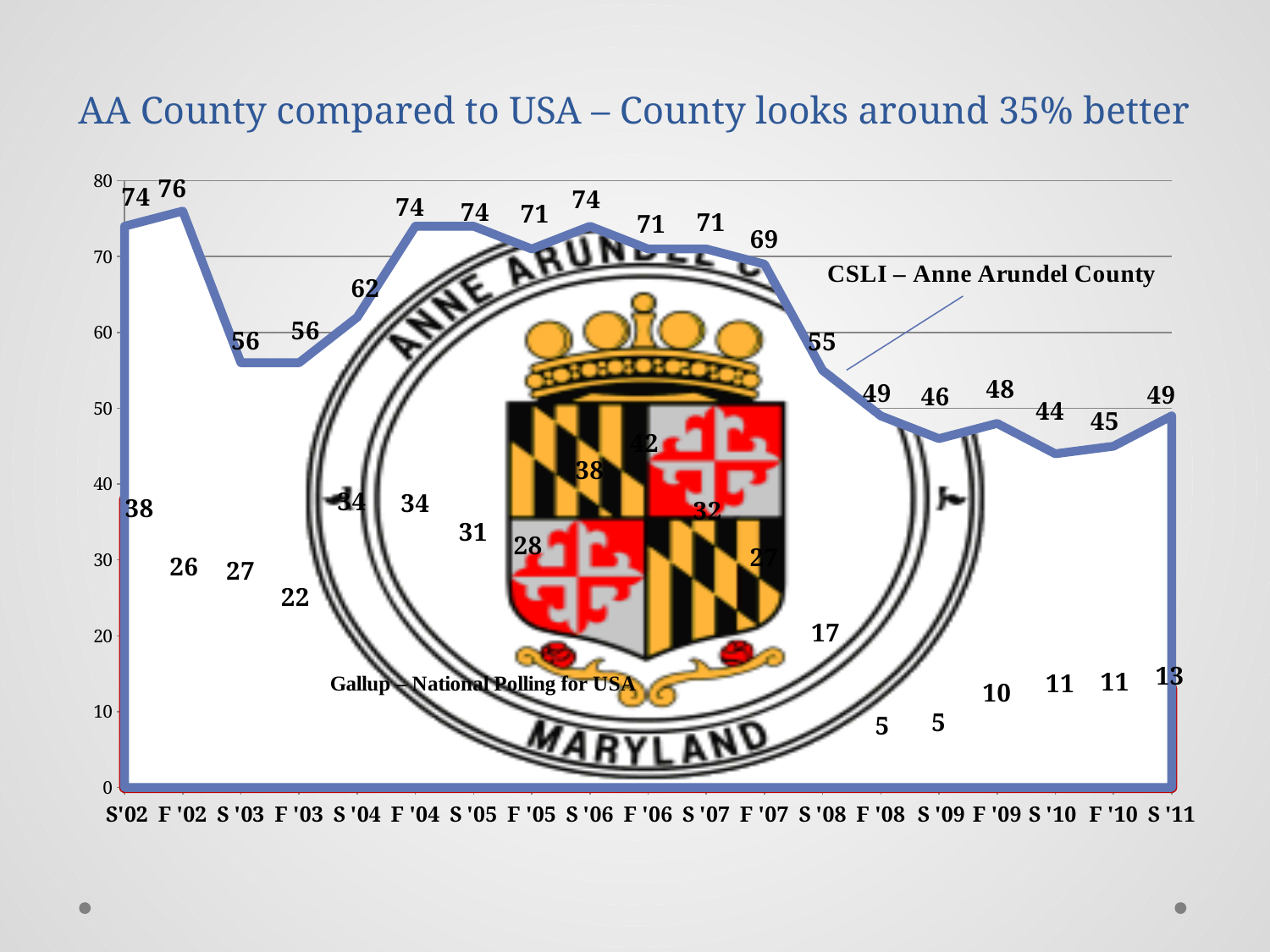
Which is larger for CSLI – Anne Arundel County: the value for S '04 or the value for F '04? F '04 What is the difference between the CSLI – Anne Arundel County value and the Gallup – National Polling for USA value for S '11? 36 What is the Gallup – National Polling for USA value for S '08? 17 In which period is the CSLI – Anne Arundel County value highest? F '02 Does the CSLI – Anne Arundel County value rise or fall from F '07 to S '10? Fall How many periods are shown on the x axis? 19 What kind of chart is shown on the slide? Area chart What is the Gallup – National Polling for USA value for F '03? 22 What is the title of the slide? AA County compared to USA – County looks around 35% better What is the CSLI – Anne Arundel County value for F '02? 76 How much higher is the CSLI – Anne Arundel County value for S '02 than for S '03? 18 In which period is the CSLI – Anne Arundel County value lowest? S '10